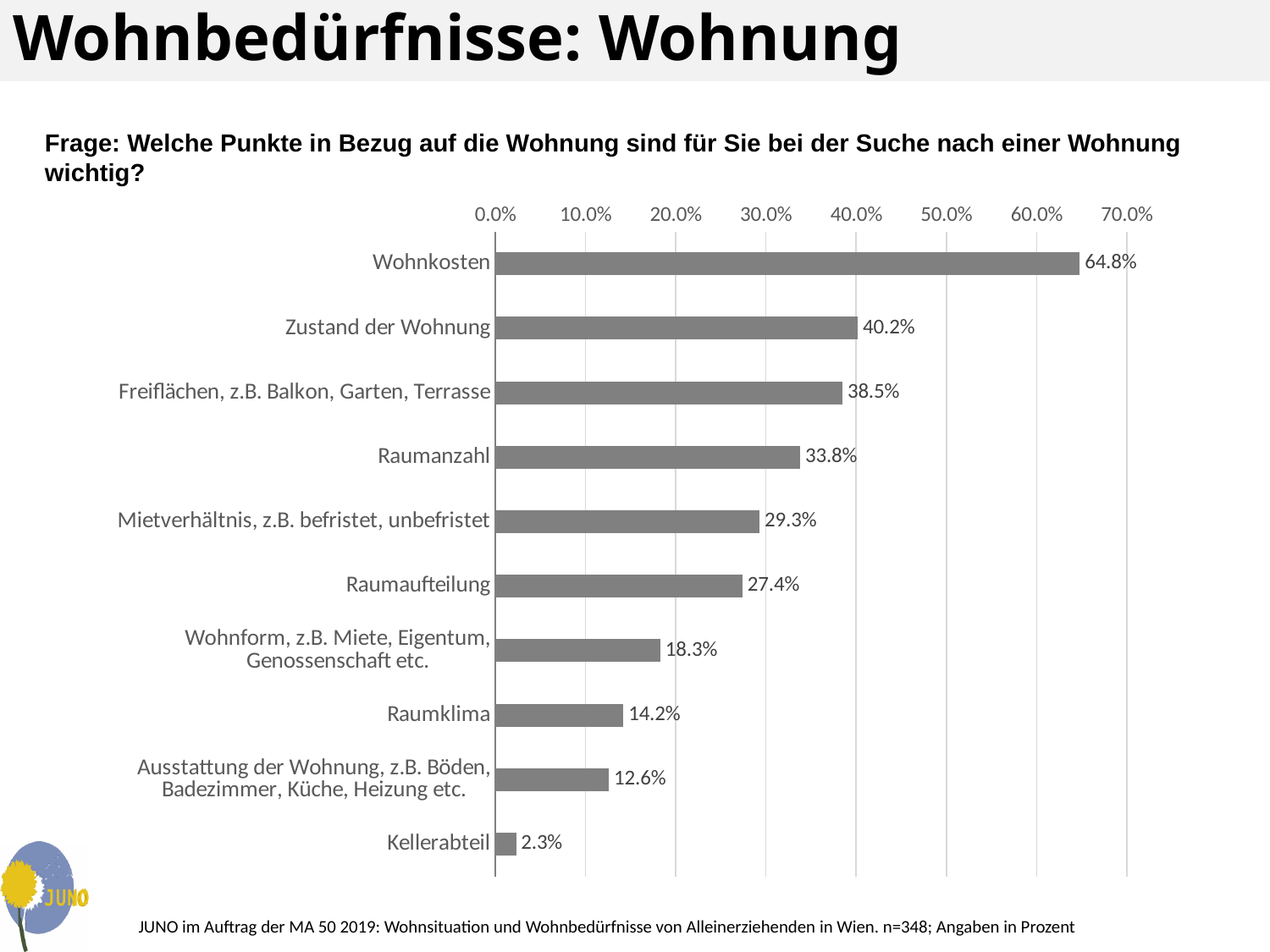
Which category has the lowest value? Kellerabteil How many categories are shown in the chart? 10 What is the difference between the values for Raumaufteilung and Kellerabteil? 25.1% Is the value for Freiflächen, z.B. Balkon, Garten, Terrasse greater or less than 30.0%? greater Which category has the highest value? Wohnkosten What is the value for Raumklima? 14.2% What is the value for Ausstattung der Wohnung, z.B. Böden, Badezimmer, Küche, Heizung etc.? 12.6% What kind of chart is shown on the slide? bar chart What is the value for Wohnkosten? 64.8% What is the value for Raumanzahl? 33.8% What is the difference between the values for Wohnkosten and Zustand der Wohnung? 24.6% Which is larger, the value for Mietverhältnis, z.B. befristet, unbefristet or the value for Raumaufteilung? Mietverhältnis, z.B. befristet, unbefristet